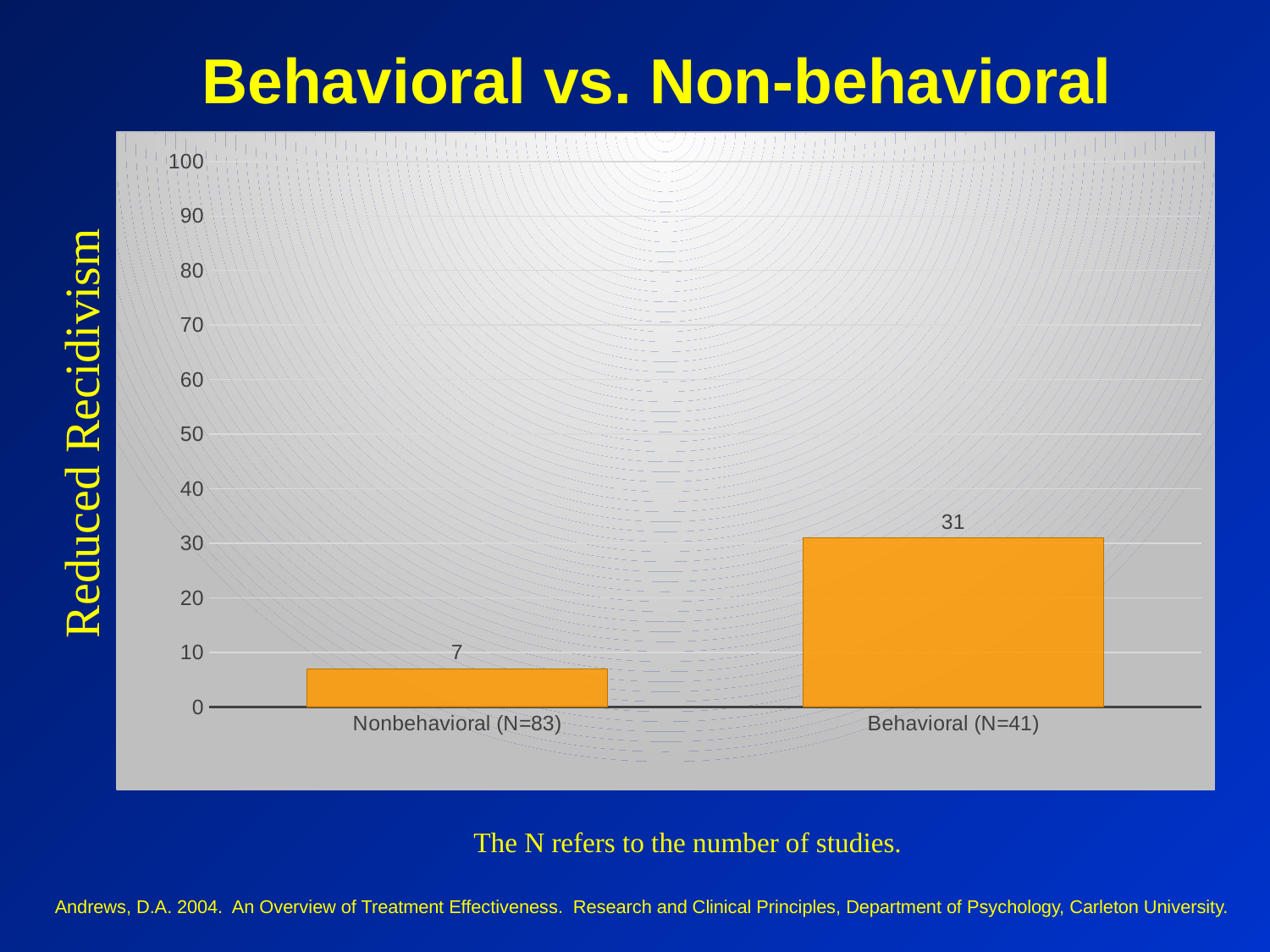
What is the title of the slide? Behavioral vs. Non-behavioral How many categories are shown in the chart? 2 What is the label of the vertical axis? Reduced Recidivism Is the value for Behavioral (N=41) greater or less than 40? less Which category has the lowest value? Nonbehavioral (N=83) What kind of chart is shown on the slide? bar chart Is the value for Nonbehavioral (N=83) greater or less than 10? less Which category has the highest value? Behavioral (N=41) What is the difference between the values for Behavioral (N=41) and Nonbehavioral (N=83)? 24 What is the value for Behavioral (N=41)? 31 What is the value for Nonbehavioral (N=83)? 7 Which is larger, the value for Behavioral (N=41) or Nonbehavioral (N=83)? Behavioral (N=41)